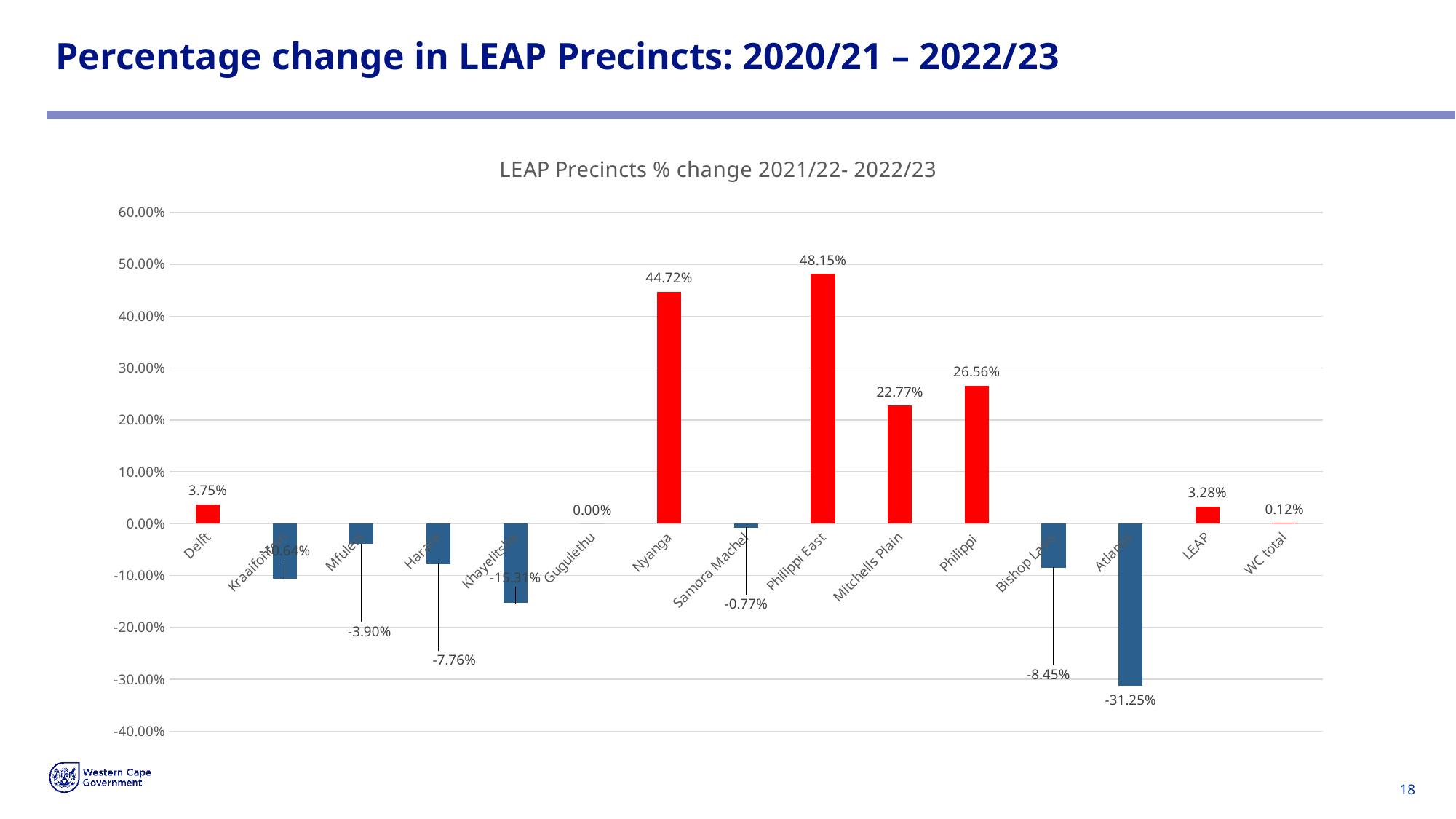
What is the difference between the values for Philippi East and Nyanga? 3.43% What is the value for Atlantis? -31.25% What is the value for WC total? 0.12% Which precinct has the lowest percentage change? Atlantis How many categories are shown on the x axis? 15 What is the value for Philippi East? 48.15% What kind of chart is shown on the slide? Bar chart What is the title of the chart? LEAP Precincts % change 2021/22- 2022/23 Which is larger, the value for Mitchells Plain or the value for Philippi? Philippi Is the value for Bishop Lavis greater or less than -10.00%? greater What is the value for Nyanga? 44.72% Which precinct has the highest percentage change? Philippi East